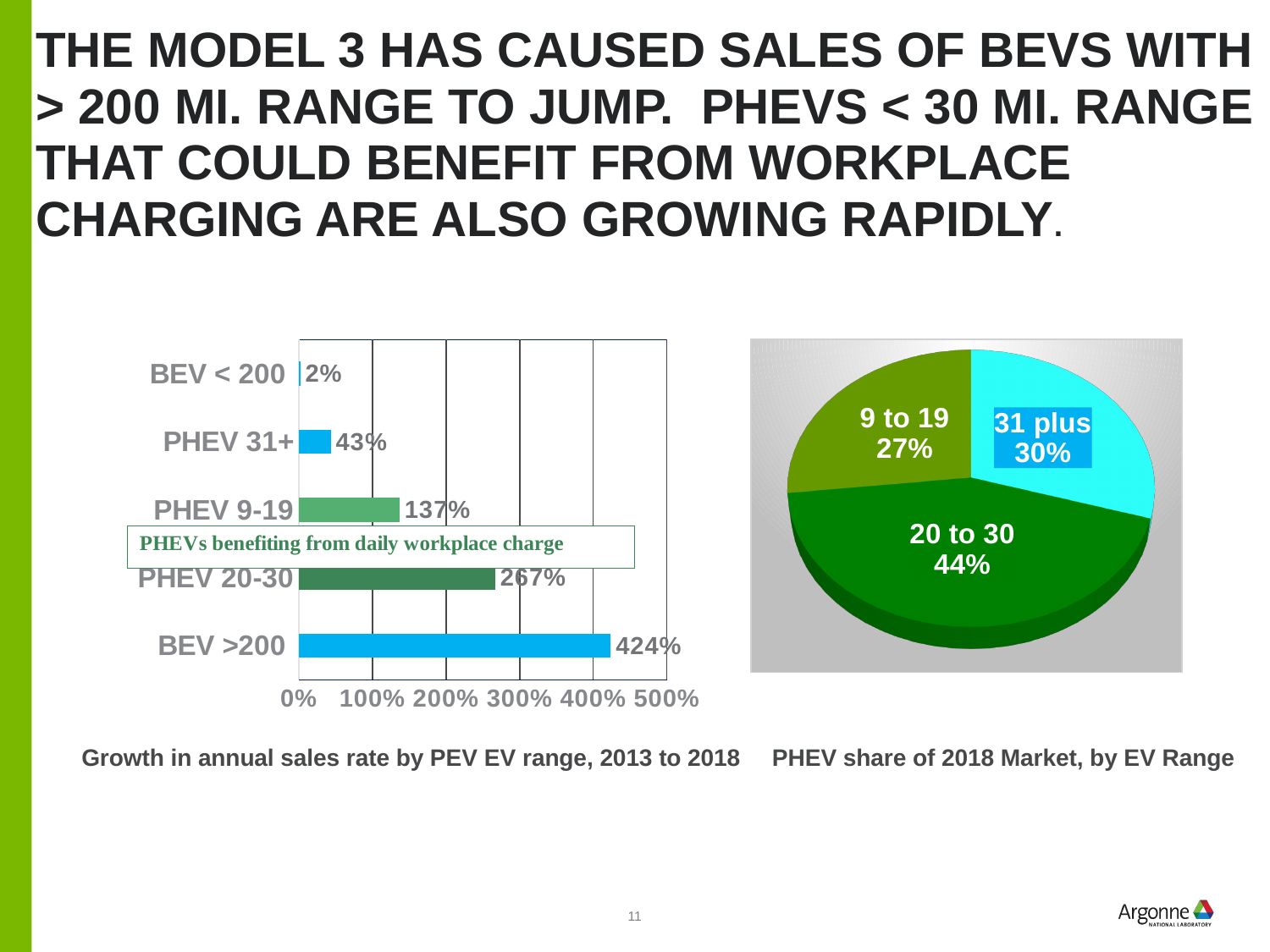
In the pie chart 'PHEV share of 2018 Market, by EV Range', what share does the 20 to 30 slice have? 44% How many categories does the bar chart 'Growth in annual sales rate by PEV EV range, 2013 to 2018' show? 5 What kind of chart is 'Growth in annual sales rate by PEV EV range, 2013 to 2018'? Bar chart In the bar chart 'Growth in annual sales rate by PEV EV range, 2013 to 2018', which category has the highest value? BEV >200 What kind of chart is 'PHEV share of 2018 Market, by EV Range'? Pie chart In the bar chart 'Growth in annual sales rate by PEV EV range, 2013 to 2018', what is the value for PHEV 9-19? 137% In the bar chart 'Growth in annual sales rate by PEV EV range, 2013 to 2018', what is the value for BEV >200? 424% In the bar chart 'Growth in annual sales rate by PEV EV range, 2013 to 2018', what is the difference between the values for BEV >200 and PHEV 20-30? 157% In the bar chart 'Growth in annual sales rate by PEV EV range, 2013 to 2018', what is the value for PHEV 31+? 43% In the bar chart 'Growth in annual sales rate by PEV EV range, 2013 to 2018', which category has the lowest value? BEV < 200 In the pie chart 'PHEV share of 2018 Market, by EV Range', which range has the smallest share? 9 to 19 In the bar chart 'Growth in annual sales rate by PEV EV range, 2013 to 2018', which is larger, PHEV 9-19 or PHEV 31+? PHEV 9-19